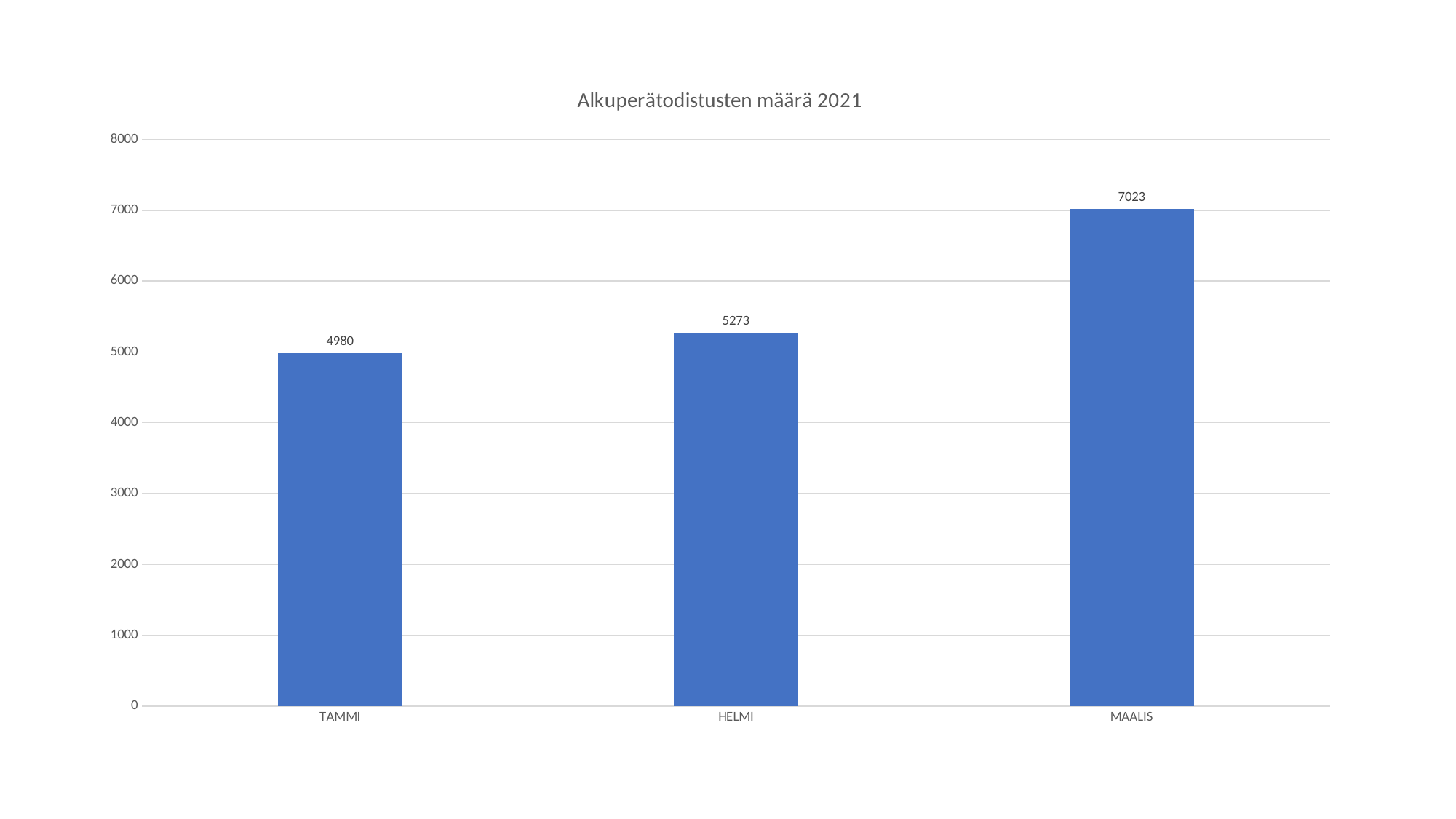
What is the value for MAALIS? 7023 What kind of chart is shown on the slide? bar chart Do the values rise or fall from TAMMI to MAALIS? rise Which category has the highest value? MAALIS What is the value for TAMMI? 4980 Which is larger, the value for HELMI or the value for MAALIS? MAALIS What is the difference between the values for HELMI and TAMMI? 293 How many categories are shown on the x axis? 3 Which category has the lowest value? TAMMI What is the difference between the values for MAALIS and TAMMI? 2043 Is the value for TAMMI greater or less than 5000? less What is the value for HELMI? 5273